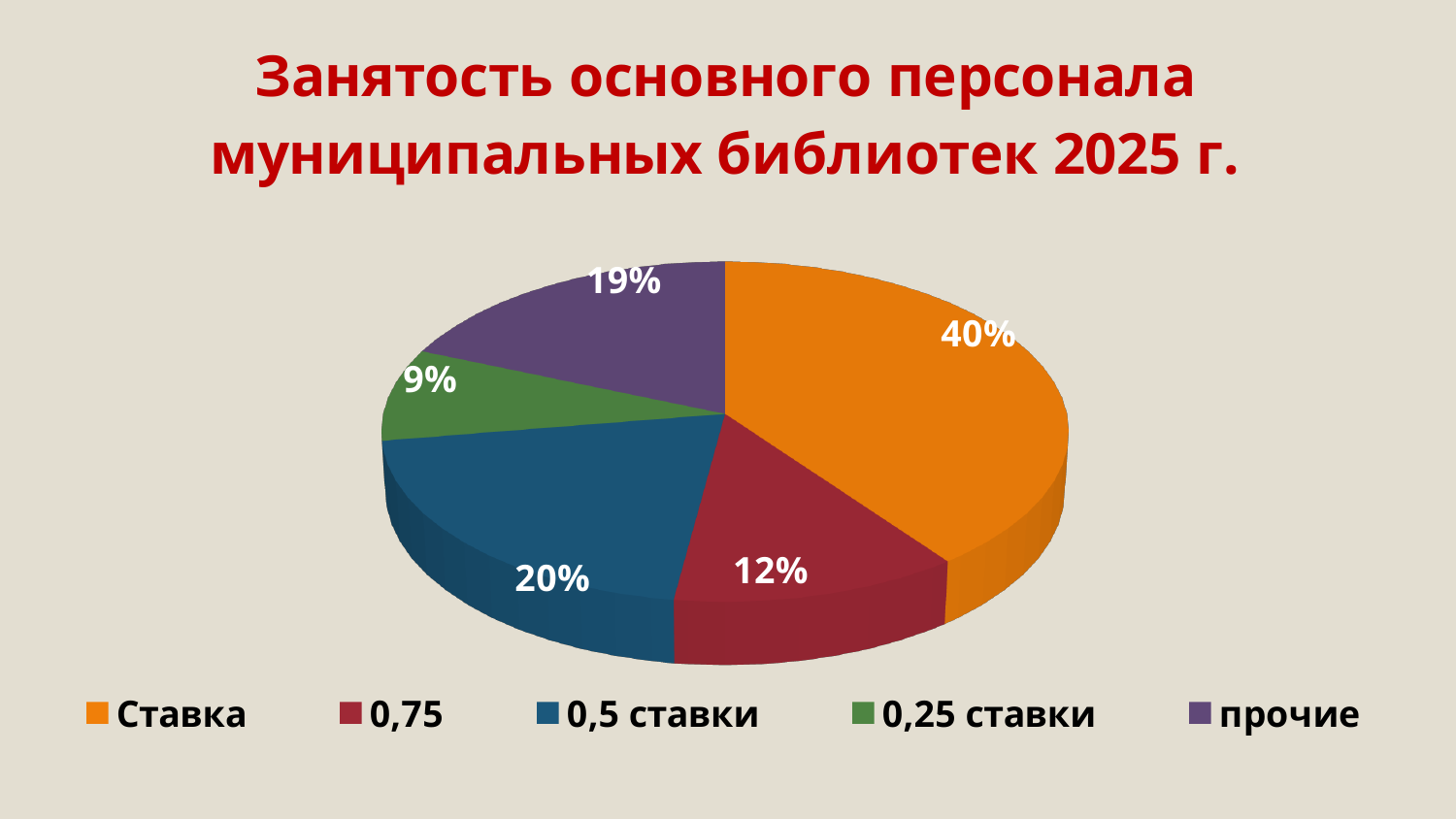
Which category has the smallest slice of the pie? 0,25 ставки What is the difference in percentage points between "Ставка" and "0,5 ставки"? 20 What kind of chart is shown on the slide? Pie chart How many categories does the pie chart show? 5 Which category has the largest slice of the pie? Ставка What is the value shown for "прочие"? 19% What is the title of the chart? Занятость основного персонала муниципальных библиотек 2025 г. Which is larger, the slice for "0,75" or the slice for "прочие"? прочие What is the value shown for "0,5 ставки"? 20% What is the value shown for "0,75"? 12% What share of the pie does the "Ставка" slice represent? 40% What is the value shown for "0,25 ставки"? 9%